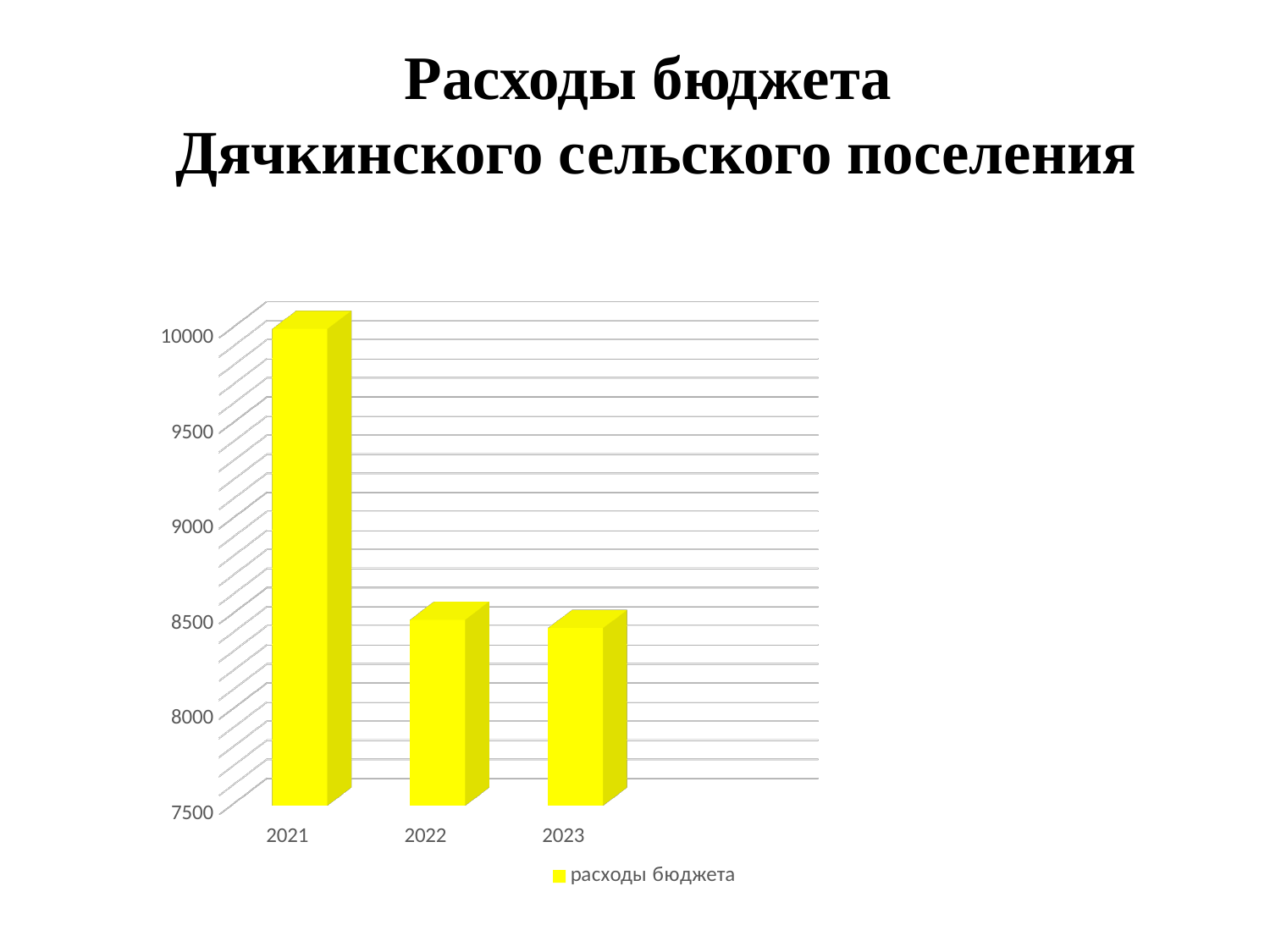
Is the value for 2021 greater or less than 9500? greater Is the value for 2022 greater or less than 9000? less What is the name of the series shown in the chart legend? расходы бюджета What kind of chart is shown on the slide? bar chart Do the values rise or fall from 2021 to 2023? fall How many years (categories) are shown on the x axis of the chart? 3 How many series does the chart legend list? 1 Which is larger, the value for 2021 or the value for 2023? 2021 Is the value for 2023 greater or less than 9000? less What colour are the bars in the chart? yellow Which year has the highest budget expenditure in the chart? 2021